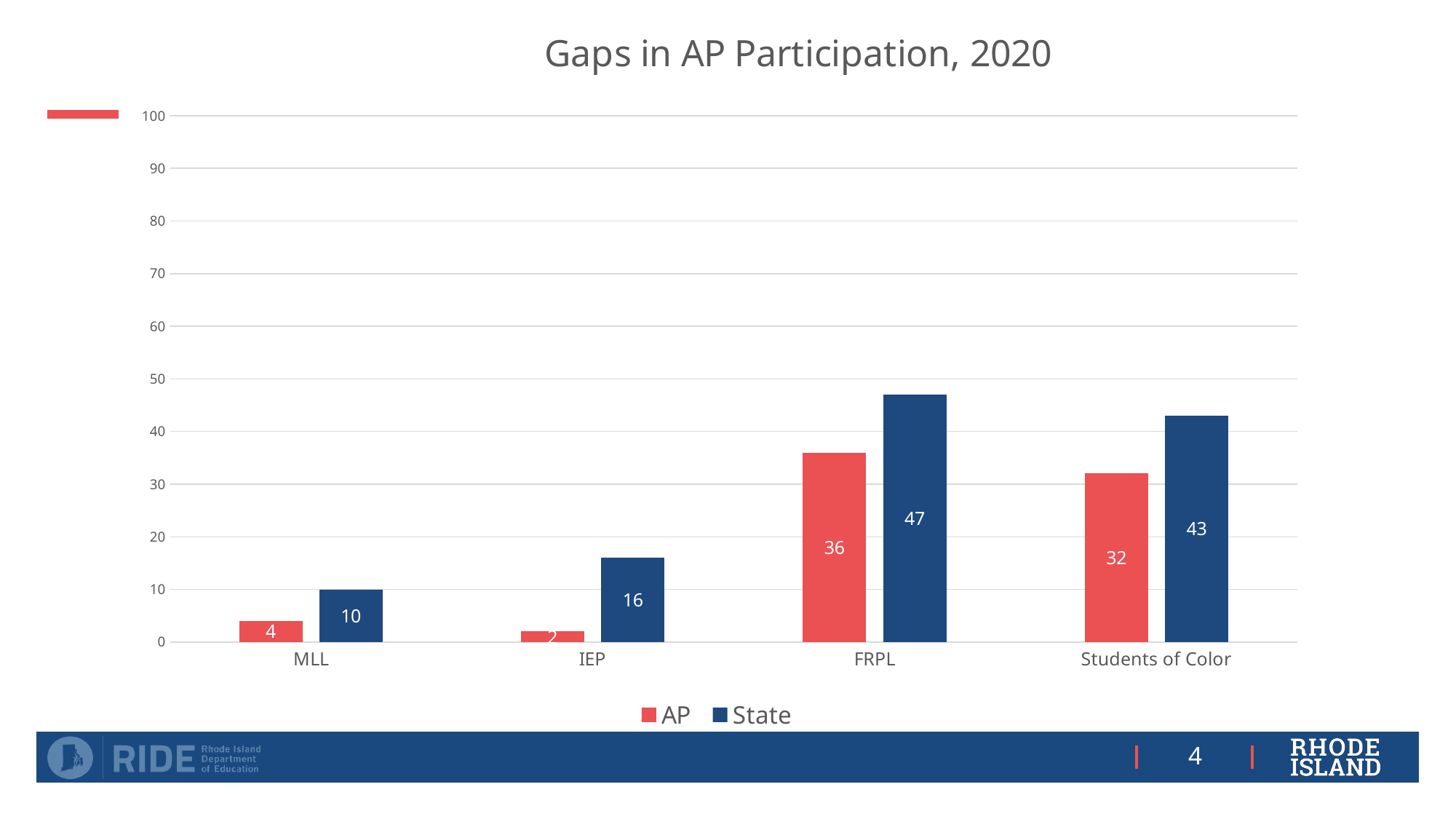
Which category has the highest State value? FRPL How many series does the legend list? 2 Which category has the lowest AP value? IEP Which is larger for Students of Color, the AP value or the State value? State What is the State value for MLL? 10 Is the AP value for IEP greater or less than 10? less What is the AP value for MLL? 4 What is the AP value for FRPL? 36 What kind of chart is shown on the slide? bar chart How many categories are shown on the x axis? 4 What is the State value for Students of Color? 43 What is the difference between the State and AP values for FRPL? 11